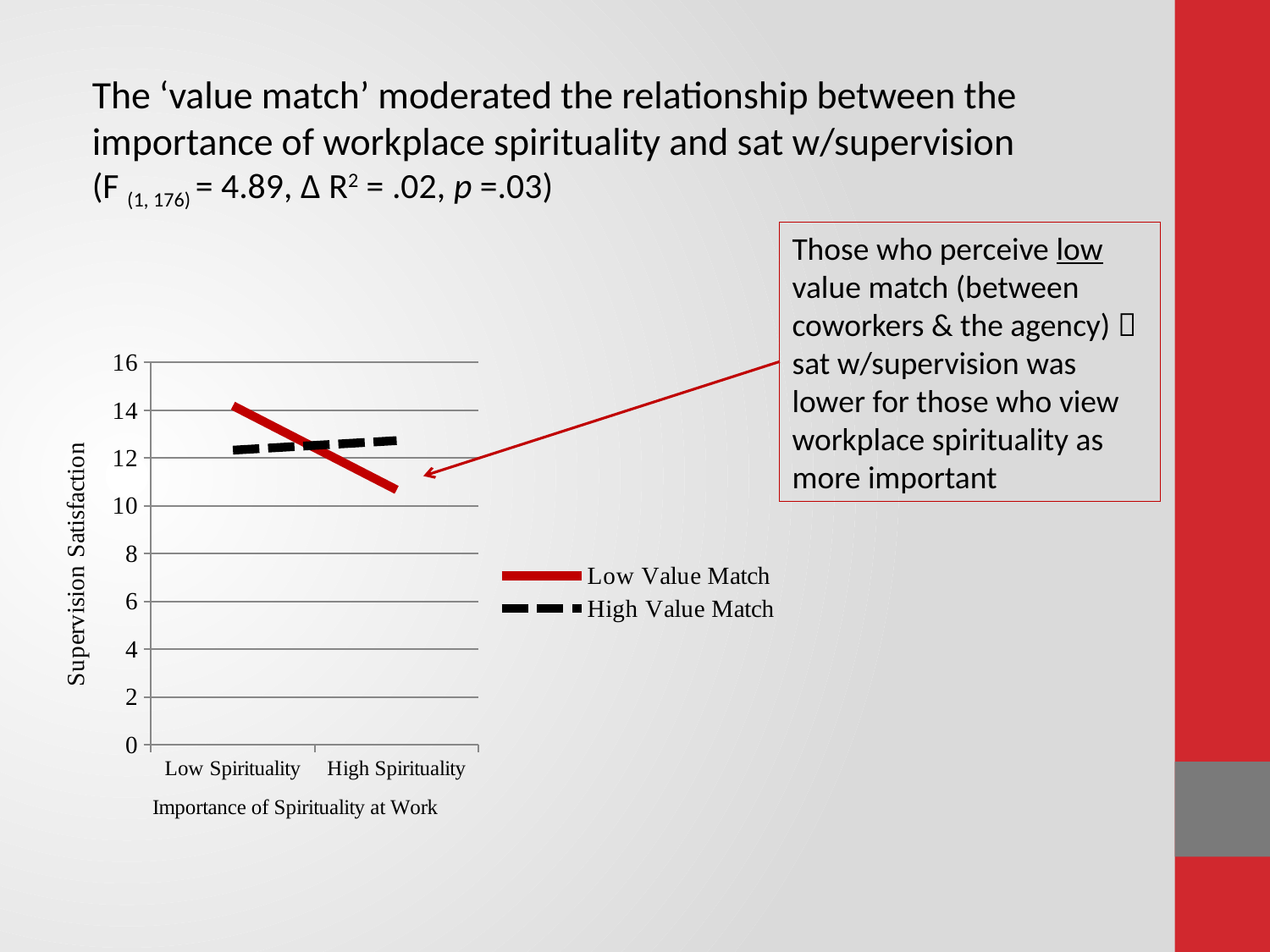
Is the Low Value Match value at Low Spirituality greater or less than 12? greater At High Spirituality, which series has the higher Supervision Satisfaction, Low Value Match or High Value Match? High Value Match Is the High Value Match value at High Spirituality greater or less than 14? less What kind of chart is shown on the slide? line chart Does the Low Value Match line rise or fall from Low Spirituality to High Spirituality? fall How many categories are shown on the x axis of the chart? 2 Does the High Value Match line rise or fall from Low Spirituality to High Spirituality? rise How many series does the chart's legend list? 2 Is the Low Value Match value at High Spirituality greater or less than 12? less What is the title of the chart's vertical axis? Supervision Satisfaction At Low Spirituality, which series has the higher Supervision Satisfaction, Low Value Match or High Value Match? Low Value Match